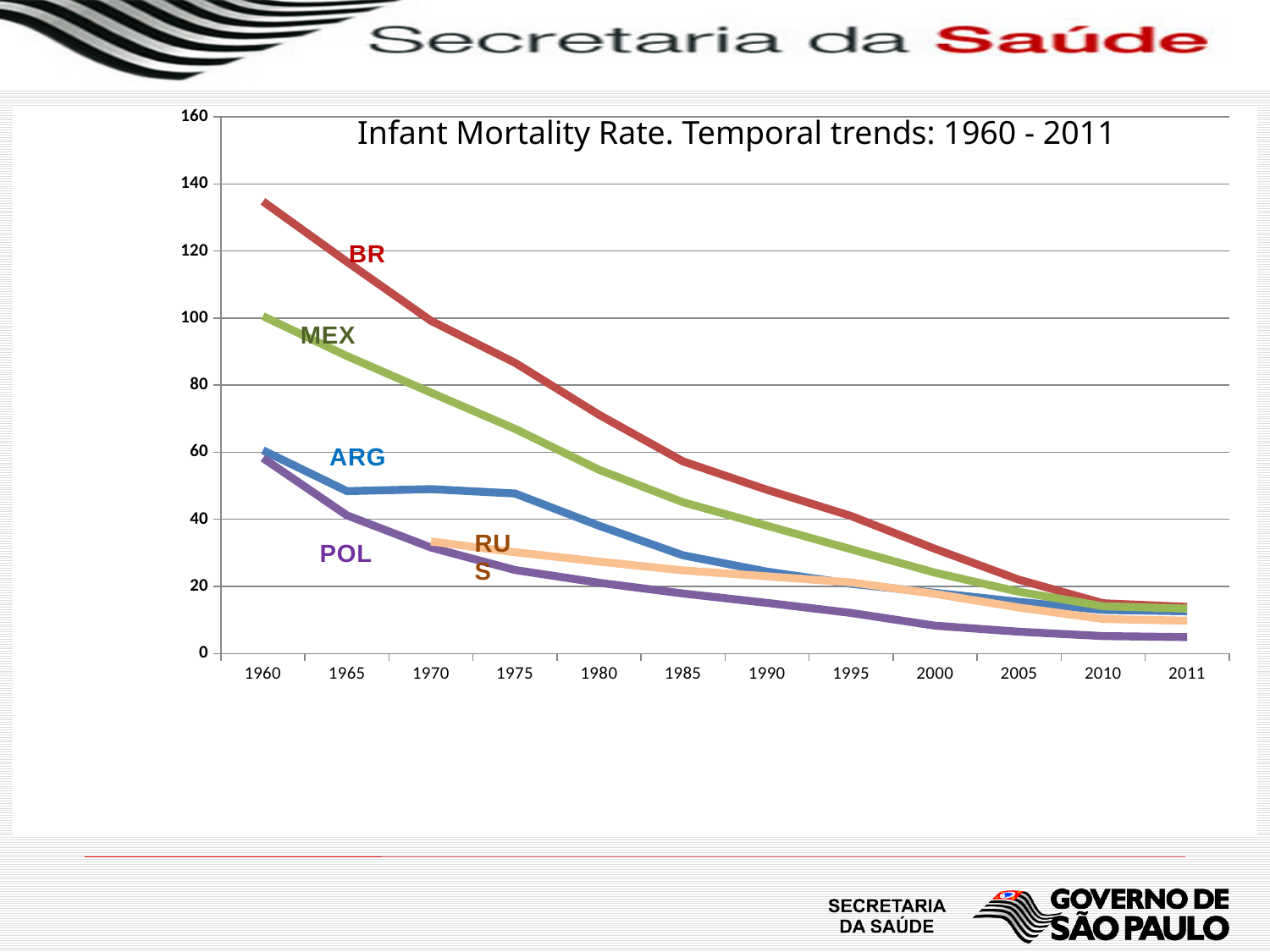
What is the title of the chart? Infant Mortality Rate. Temporal trends: 1960 - 2011 How many year labels are shown on the x axis? 12 Is the value for ARG in 1985 greater or less than 40? less Is the value for POL in 2000 greater or less than 20? less Which is larger in 1980, the value for BR or the value for MEX? BR Is the value for BR in 1975 greater or less than 80? greater Which country has the highest infant mortality rate in 1960? BR How many countries (series) are plotted on the chart? 5 Do the infant mortality rates rise or fall from 1960 to 2011? fall Which country has the lowest infant mortality rate in 2011? POL What type of chart is shown on the slide? line chart